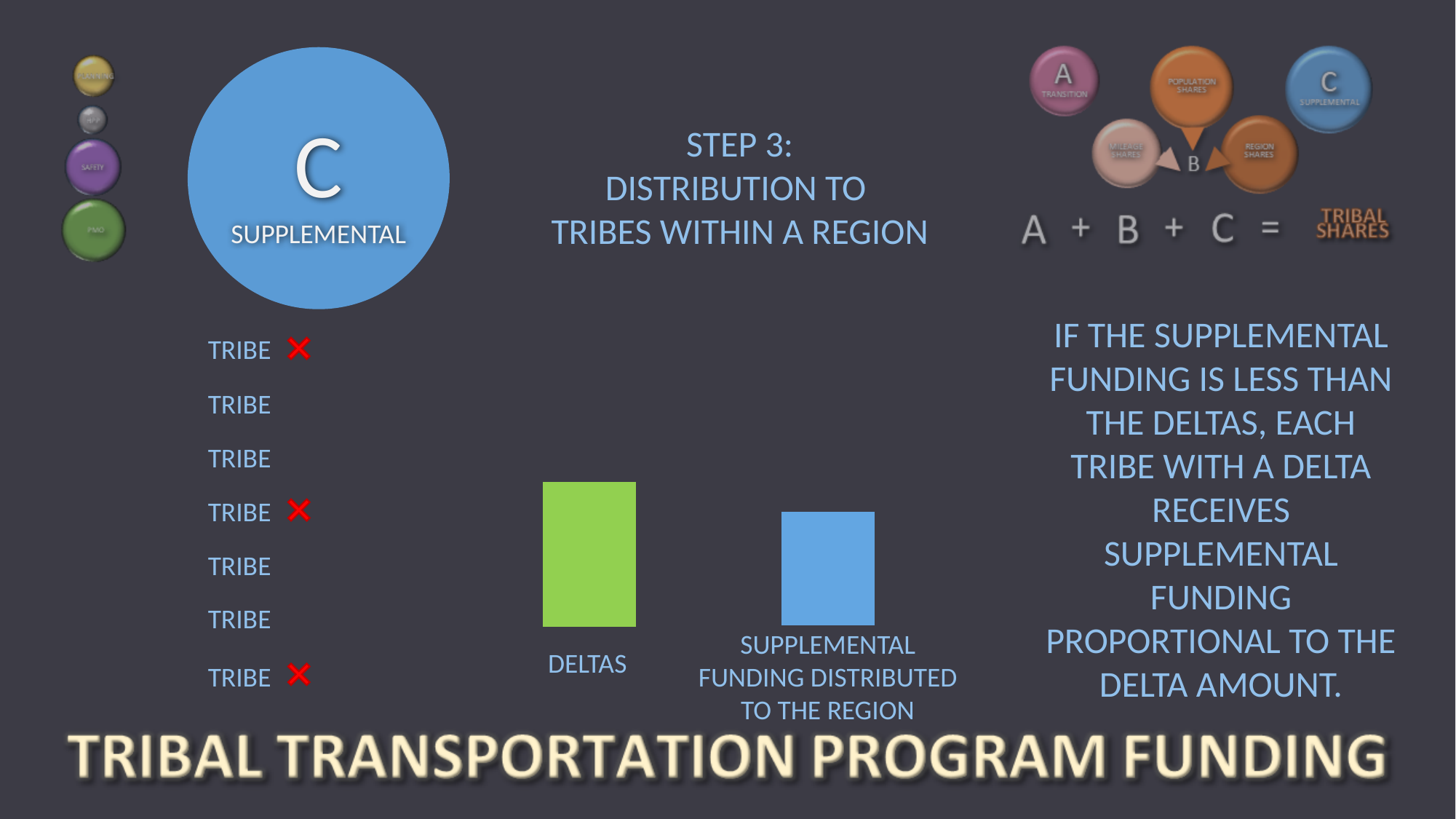
Which category has the lowest bar in the chart? SUPPLEMENTAL FUNDING DISTRIBUTED TO THE REGION What kind of chart is shown in the middle of the slide, next to the list of tribes? bar chart Which bar in the chart is taller, DELTAS or SUPPLEMENTAL FUNDING DISTRIBUTED TO THE REGION? DELTAS What colour is the SUPPLEMENTAL FUNDING DISTRIBUTED TO THE REGION bar in the chart? blue What colour is the DELTAS bar in the chart? green How many bars does the bar chart in the middle of the slide have? 2 Is the SUPPLEMENTAL FUNDING DISTRIBUTED TO THE REGION bar larger or smaller than the DELTAS bar? smaller Which category has the highest bar in the chart? DELTAS